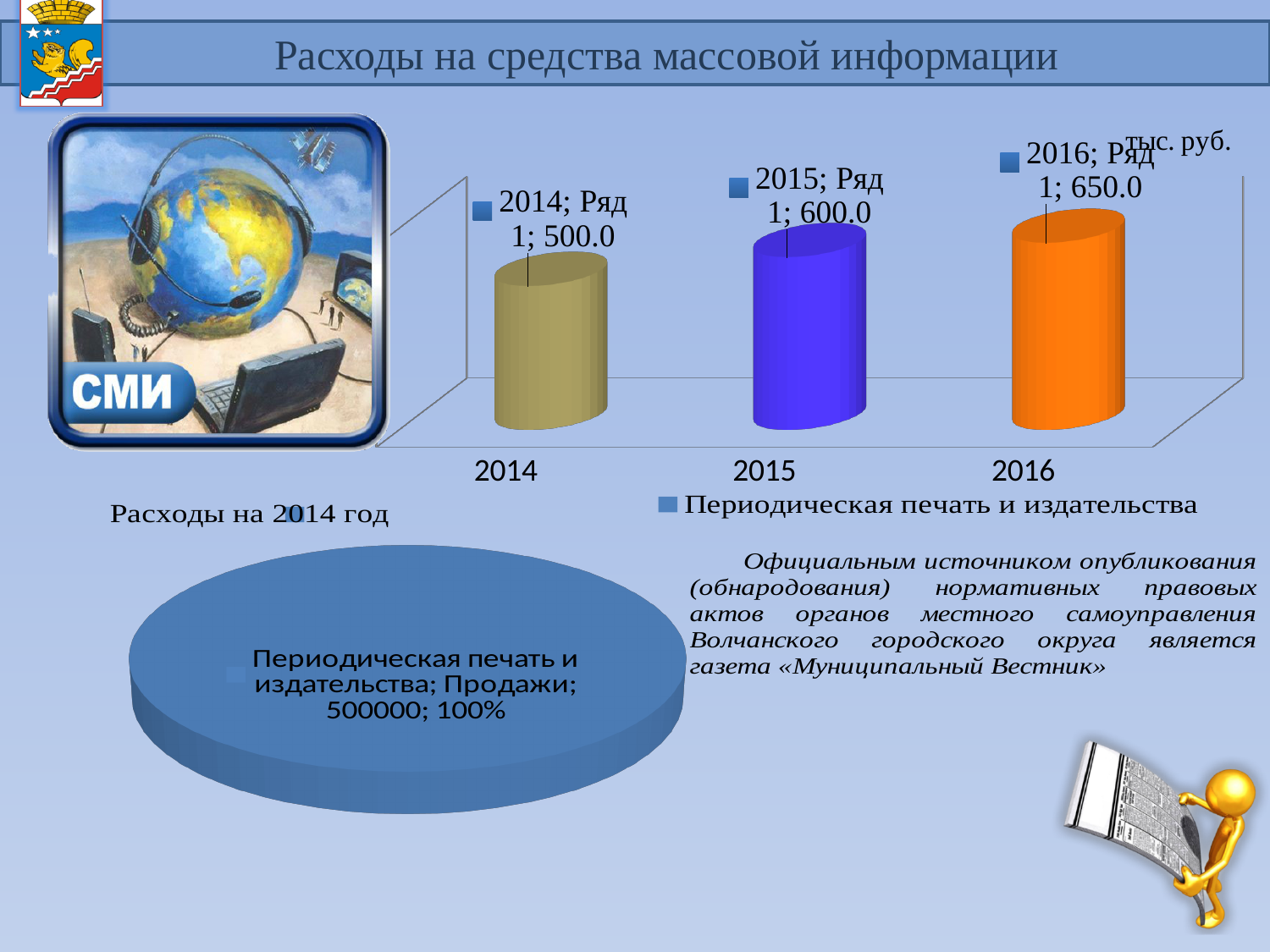
In the bar chart at the top right, which is larger, the value for 2015 or the value for 2016? 2016 In the bar chart at the top right, how many years are shown on the x axis? 3 What kind of chart is shown at the top right of the slide? bar chart In the bar chart at the top right, what is the value for 2014? 500.0 In the bar chart at the top right, which year has the highest value? 2016 In the bar chart at the top right, what is the value for 2016? 650.0 In the pie chart titled 'Расходы на 2014 год', what share does the slice 'Периодическая печать и издательства' have? 100% In the bar chart at the top right, what is the difference between the values for 2016 and 2014? 150.0 In the bar chart at the top right, what is the value for 2015? 600.0 In the bar chart at the top right, do the values rise or fall from 2014 to 2016? rise In the bar chart at the top right, what series name does the legend show? Периодическая печать и издательства In the bar chart at the top right, which year has the lowest value? 2014